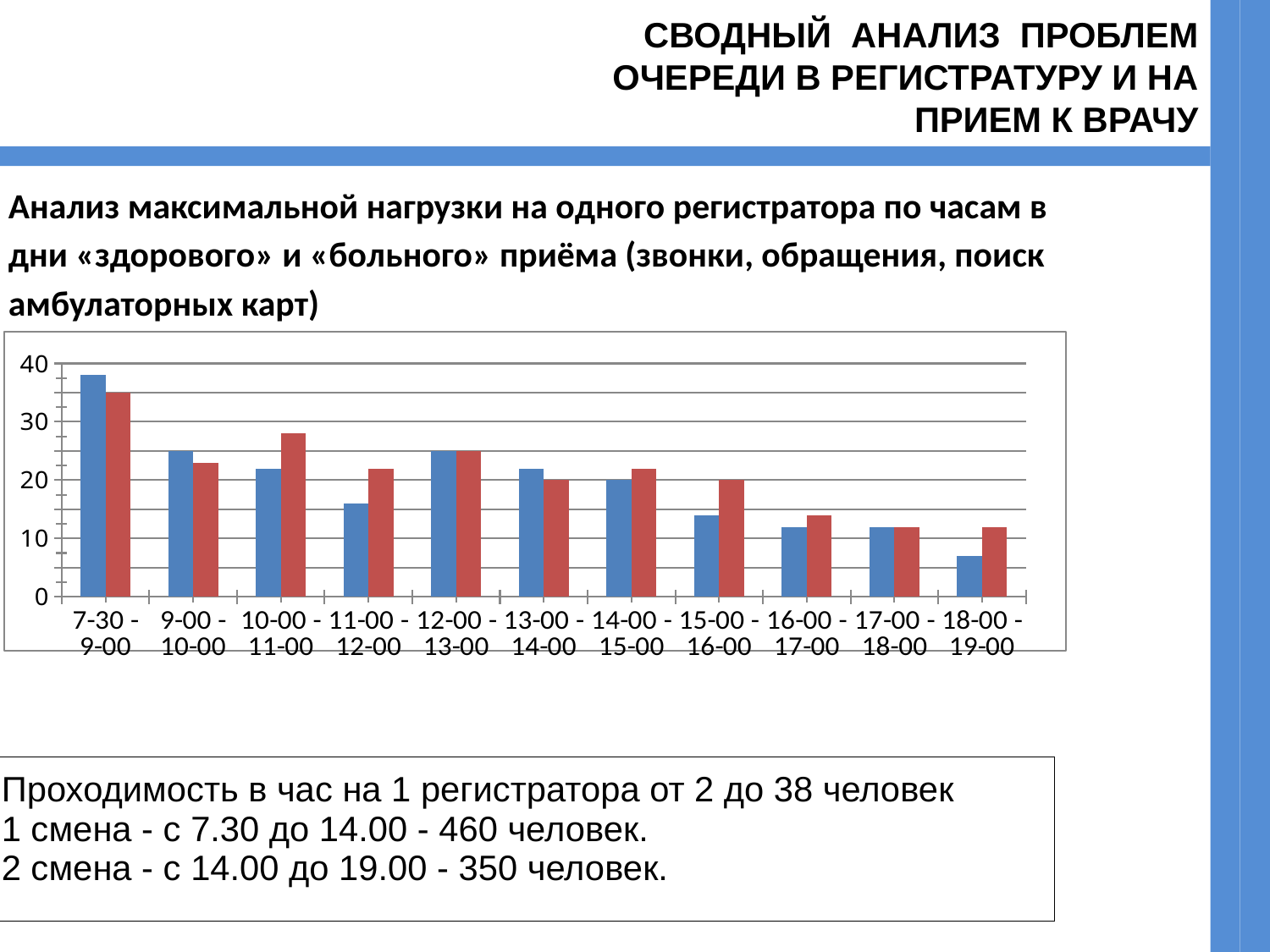
Is the red bar for 10-00 - 11-00 greater or less than 20? greater Is the blue bar for 18-00 - 19-00 greater or less than 10? less What kind of chart is shown on the slide? bar chart How many bars are plotted for each time slot in the chart? 2 Is the blue bar for 11-00 - 12-00 greater or less than 20? less Which time slot has the highest red bar in the chart? 7-30 - 9-00 Which time slot has the lowest blue bar in the chart? 18-00 - 19-00 For the 11-00 - 12-00 time slot, which bar is taller, the blue one or the red one? red Which time slot has the highest blue bar in the chart? 7-30 - 9-00 How many time-slot categories are shown on the x axis of the chart? 11 Do the blue bars generally rise or fall from left to right across the time slots? fall